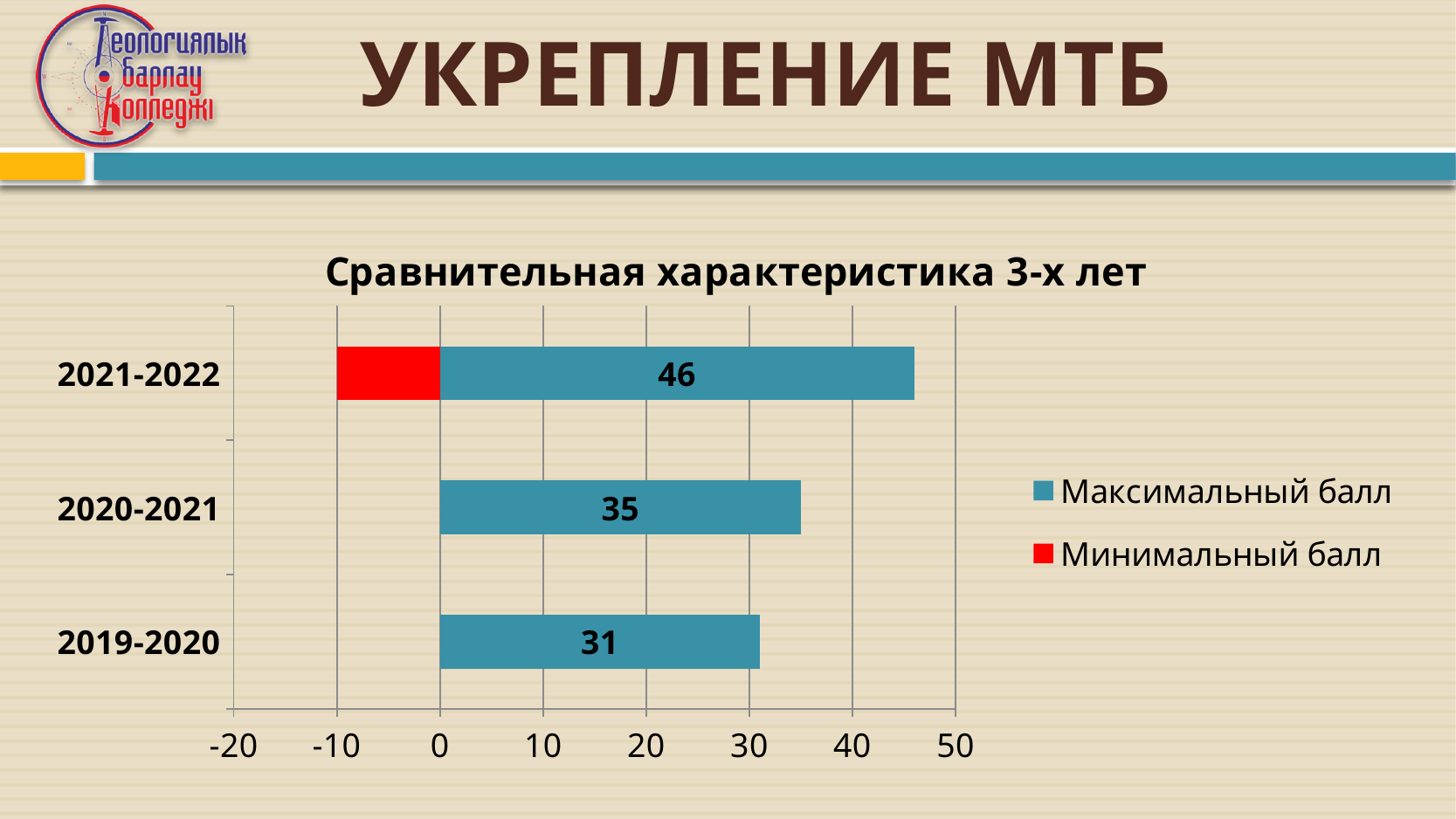
What is the value of Максимальный балл for 2020-2021? 35 How many year categories are shown on the chart? 3 What is the difference between the Максимальный балл for 2021-2022 and 2020-2021? 11 What is the value of Максимальный балл for 2019-2020? 31 What is the difference between the Максимальный балл for 2020-2021 and 2019-2020? 4 How many series does the legend list? 2 What is the value of Максимальный балл for 2021-2022? 46 Is the value of Минимальный балл for 2021-2022 greater or less than 0? less Which year has the lowest Максимальный балл? 2019-2020 Which year has the highest Максимальный балл? 2021-2022 Which has a larger Максимальный балл, 2020-2021 or 2019-2020? 2020-2021 What kind of chart is shown on the slide? bar chart